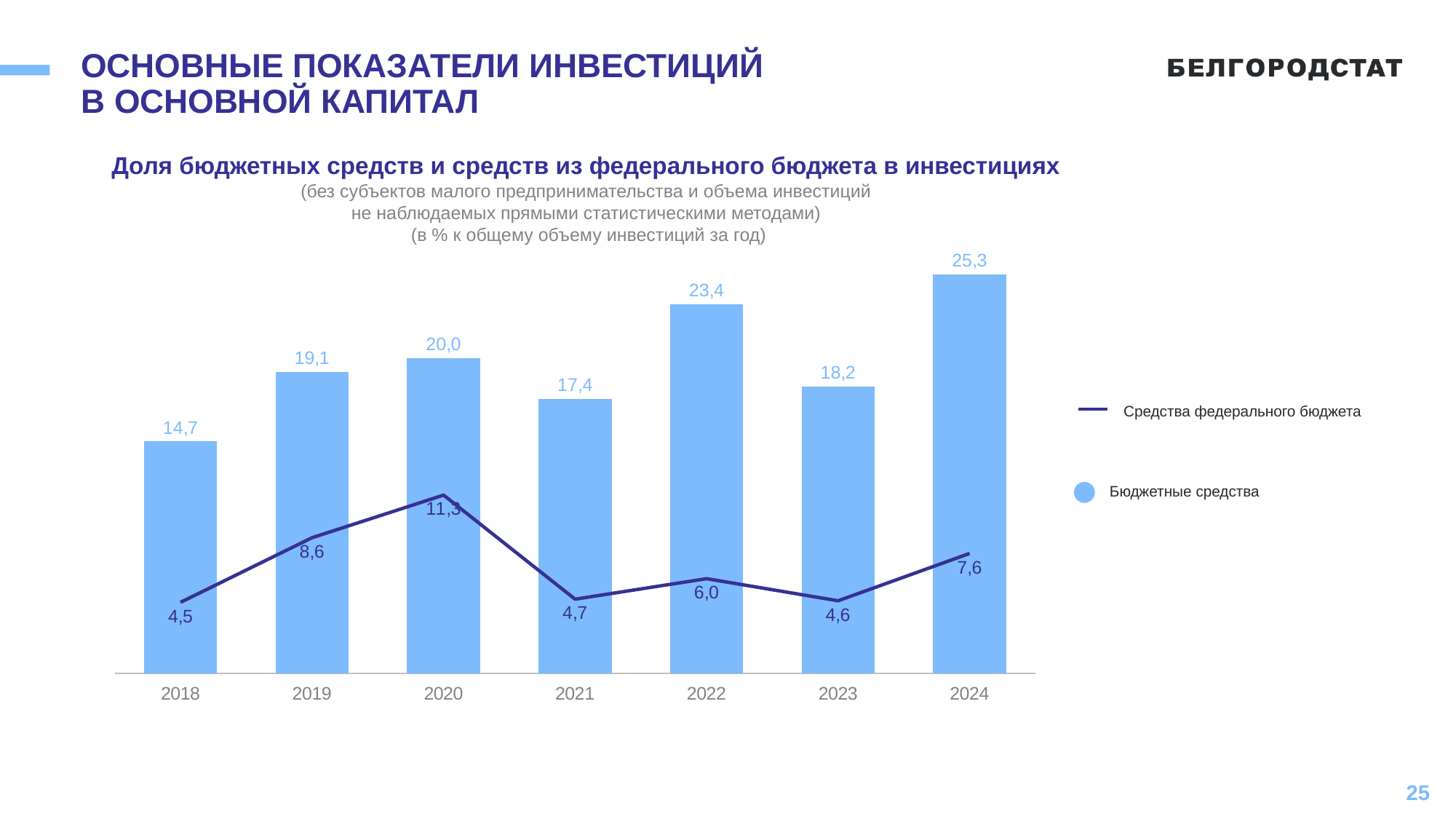
Which is larger: Бюджетные средства in 2020 or in 2021? 2020 How many series does the legend list? 2 What is the value of Средства федерального бюджета for 2019? 8,6 In which year is Бюджетные средства the highest? 2024 What is the value of Бюджетные средства for 2024? 25,3 What is the value of Бюджетные средства for 2018? 14,7 How many years are shown on the x axis? 7 In which year is Средства федерального бюджета the highest? 2020 In which year is Бюджетные средства the lowest? 2018 What is the value of Средства федерального бюджета for 2023? 4,6 Which series is drawn as a line? Средства федерального бюджета What is the difference between Бюджетные средства in 2024 and in 2023? 7,1